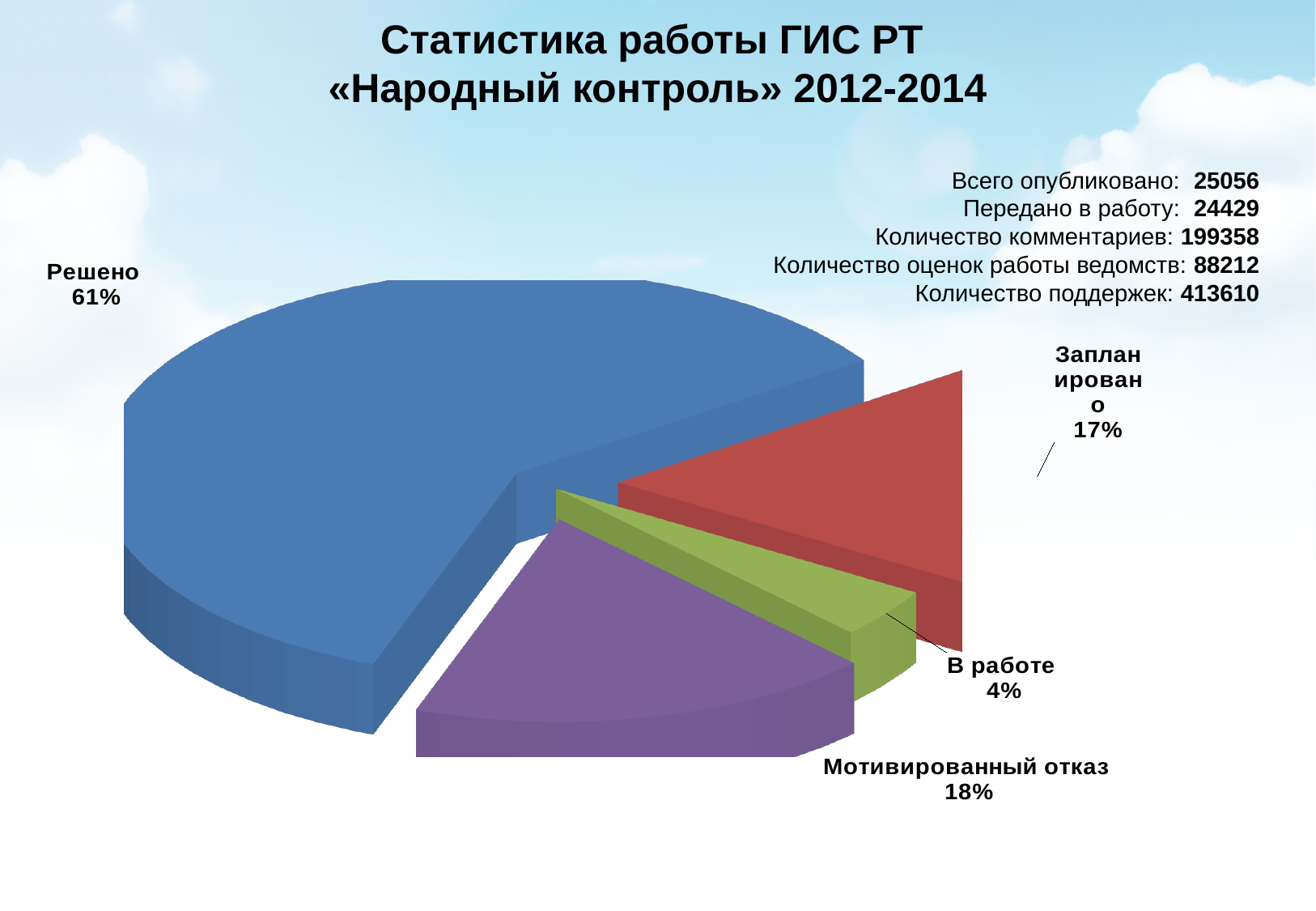
Which category has the smallest slice of the pie? В работе What is the difference in percentage points between the "Решено" and "Мотивированный отказ" slices? 43 What colour is the "Решено" slice? Blue What share of the pie does the "Мотивированный отказ" slice represent? 18% What share of the pie does the "Запланировано" slice represent? 17% What share of the pie does the "Решено" slice represent? 61% What type of chart is shown on the slide? Pie chart What is the difference in percentage points between the "Запланировано" and "В работе" slices? 13 Which category has the largest slice of the pie? Решено How many slices does the pie chart have? 4 Which slice is larger, "Мотивированный отказ" or "Запланировано"? Мотивированный отказ